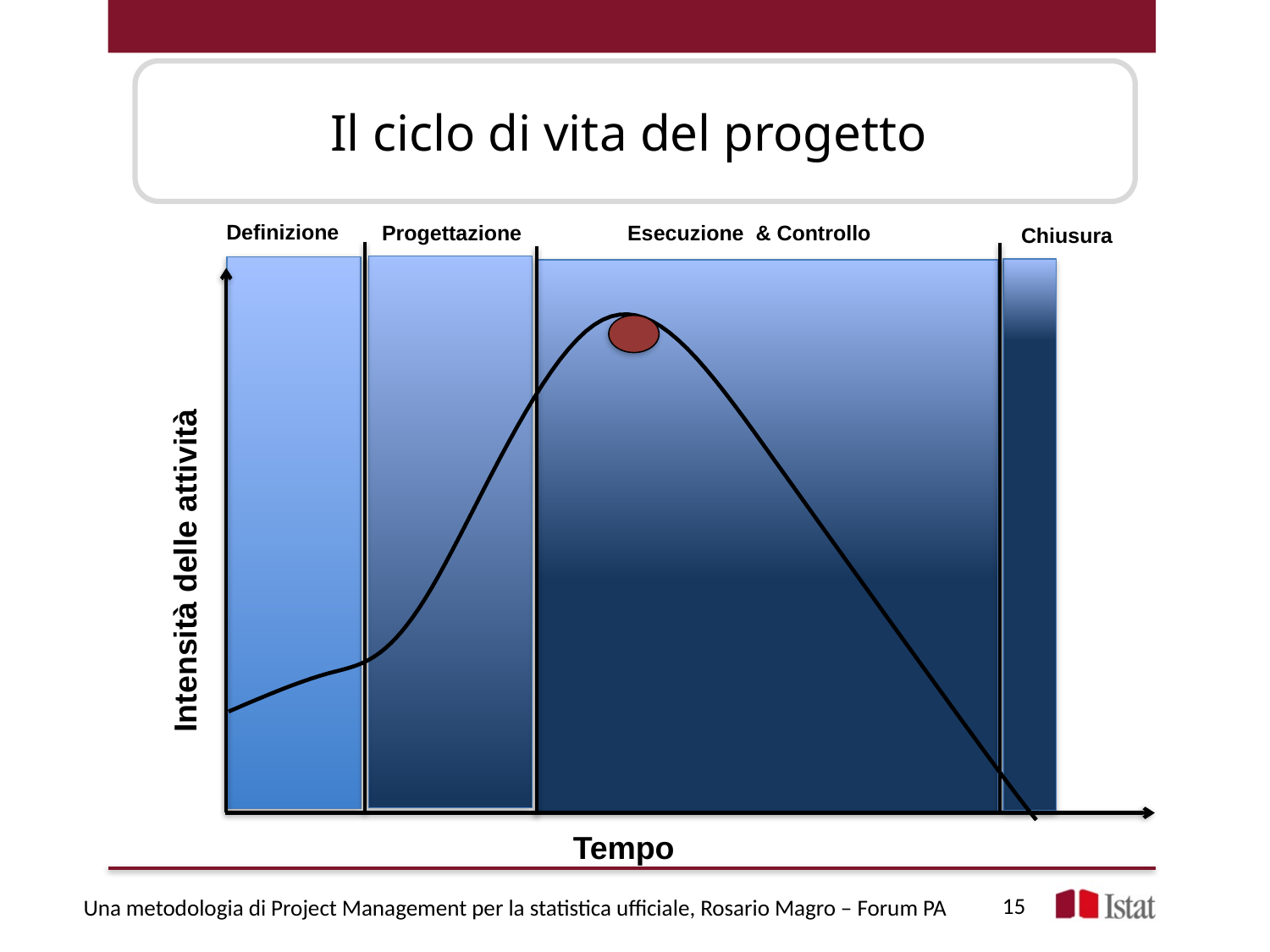
Does the curve rise or fall during the Chiusura phase? fall In which phase is the curve at its lowest point? Chiusura What is the label of the horizontal axis? Tempo What kind of chart is shown on the slide? line chart What is the label of the vertical axis? Intensità delle attività Which phase is the first one along the time axis? Definizione In which phase does the curve reach its peak? Esecuzione & Controllo Which phase occupies the widest section of the time axis? Esecuzione & Controllo Does the curve rise or fall during the Progettazione phase? rise How many project phases are labelled along the top of the chart? 4 What is the title of the chart on the slide? Il ciclo di vita del progetto Is the activity intensity higher at the end of Progettazione or at the start of Definizione? end of Progettazione